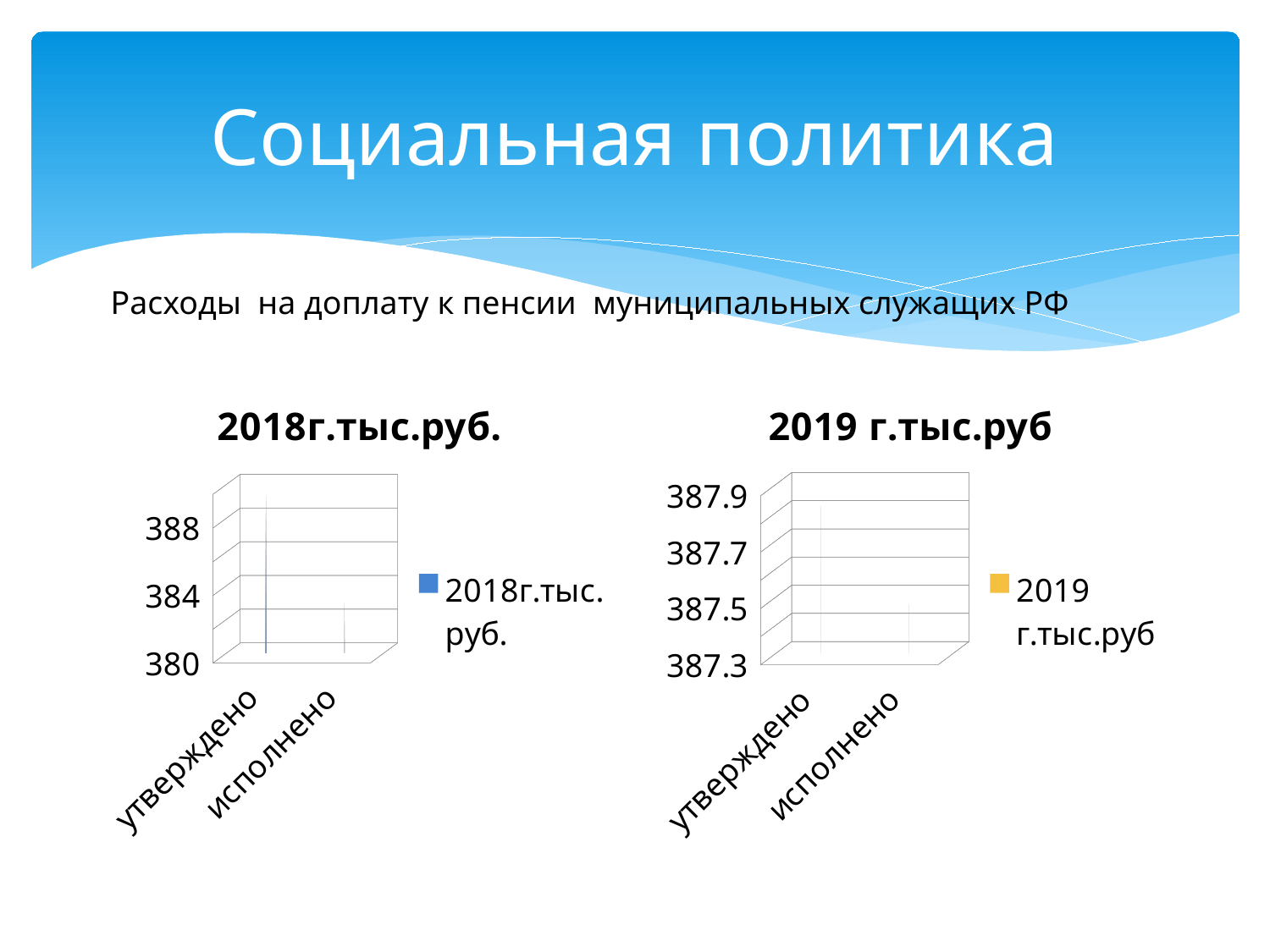
How many categories are shown on the x axis of the chart titled "2018г.тыс.руб."? 2 What is the title of the chart on the right side of the slide? 2019 г.тыс.руб What kind of chart is the chart titled "2019 г.тыс.руб"? bar chart What is the legend entry of the chart on the left side of the slide? 2018г.тыс.руб. How many series does the legend of the chart titled "2019 г.тыс.руб" list? 1 In the chart titled "2018г.тыс.руб.", which category has the higher value, утверждено or исполнено? утверждено How many series does the legend of the chart titled "2018г.тыс.руб." list? 1 In the chart titled "2018г.тыс.руб.", which category has the highest value? утверждено How many categories are shown on the x axis of the chart titled "2019 г.тыс.руб"? 2 What kind of chart is the chart titled "2018г.тыс.руб."? bar chart What is the lowest value shown on the y axis of the chart titled "2019 г.тыс.руб"? 387.3